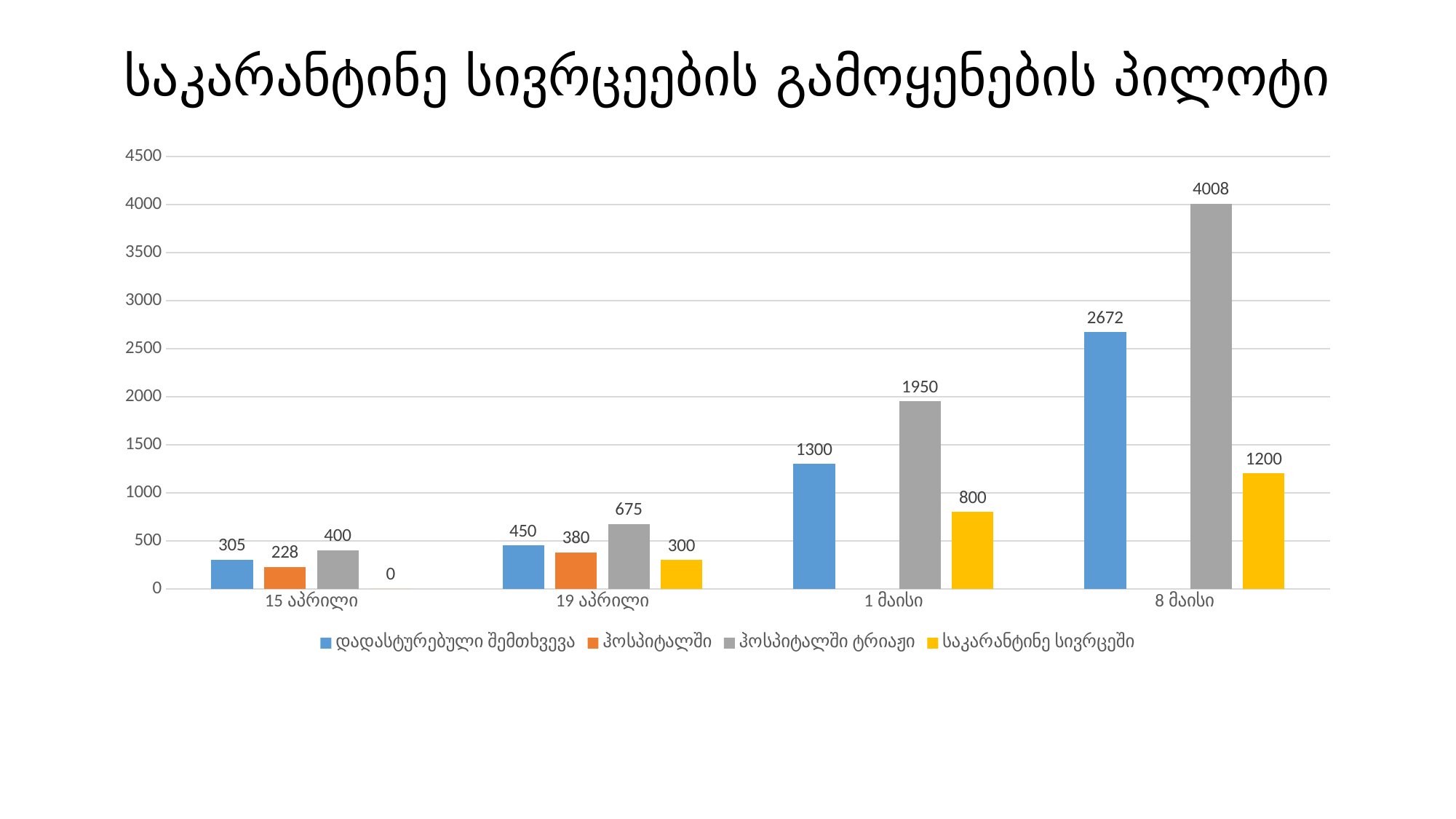
On which date is the value for დადასტურებული შემთხვევა lowest? 15 აპრილი What type of chart is shown on the slide? bar chart What is the value for ჰოსპიტალში on 19 აპრილი? 380 What is the value for ჰოსპიტალში ტრიაჟი on 8 მაისი? 4008 What is the value for დადასტურებული შემთხვევა on 1 მაისი? 1300 How many categories are shown on the x axis? 4 What is the value for საკარანტინე სივრცეში on 15 აპრილი? 0 What is the difference between the ჰოსპიტალში ტრიაჟი value and the დადასტურებული შემთხვევა value on 8 მაისი? 1336 On which date is the value for ჰოსპიტალში ტრიაჟი highest? 8 მაისი How many series does the legend list? 4 Do the values for საკარანტინე სივრცეში rise or fall from 15 აპრილი to 8 მაისი? rise Which is larger on 1 მაისი: საკარანტინე სივრცეში or დადასტურებული შემთხვევა? დადასტურებული შემთხვევა